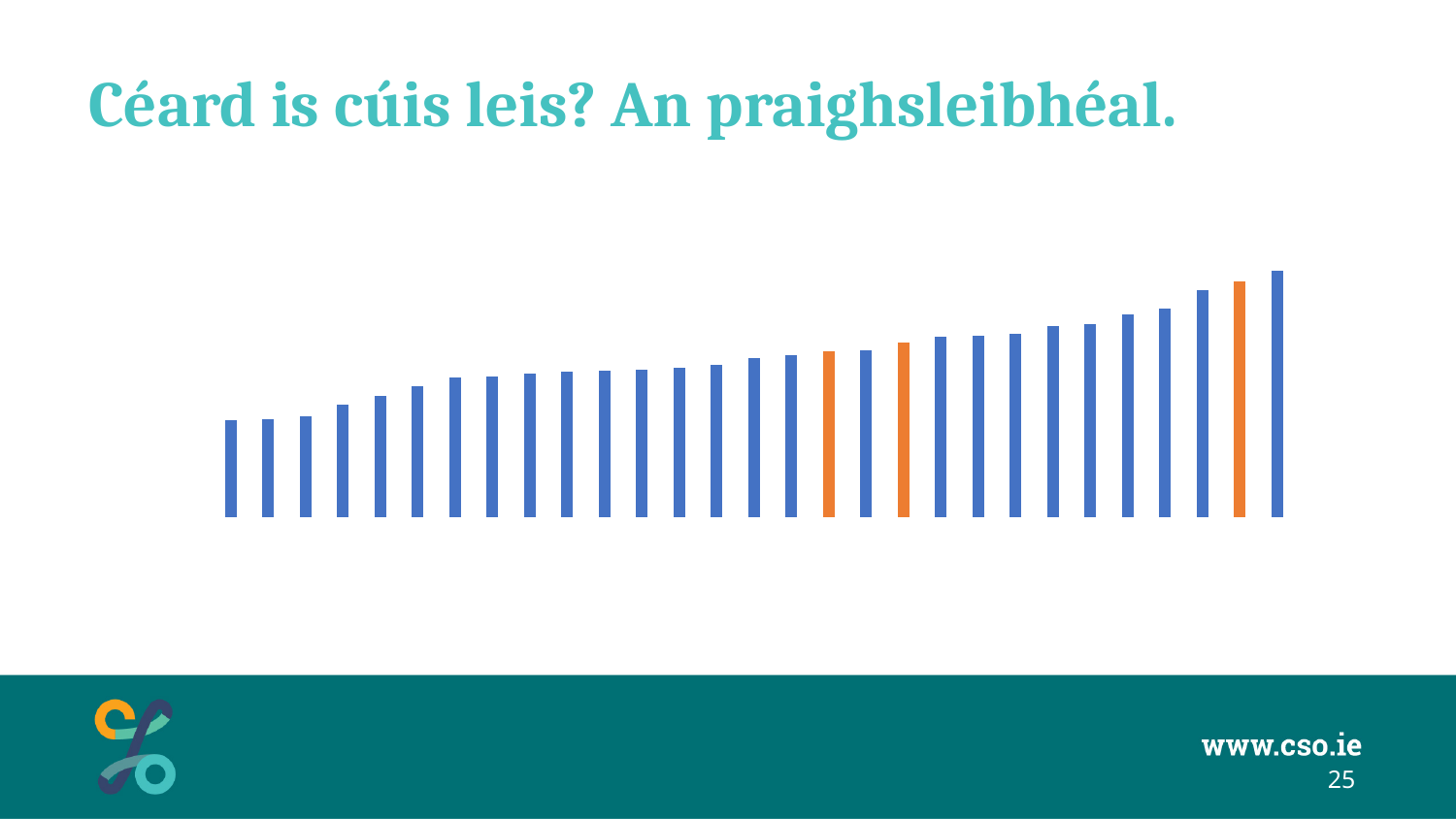
What is the title text shown above the chart? Céard is cúis leis? An praighsleibhéal. Do the bar values generally rise or fall from left to right across the chart? rise Is the rightmost bar taller or shorter than the leftmost bar? taller What two colours are used for the bars in the chart? blue and orange What kind of chart is shown on the slide? bar chart Is the first orange bar (from the left) taller or shorter than the last orange bar? shorter Which bar is the tallest in the chart: the leftmost or the rightmost? the rightmost Which bar is the shortest in the chart: the leftmost or the rightmost? the leftmost How many bars in the chart are coloured orange? 3